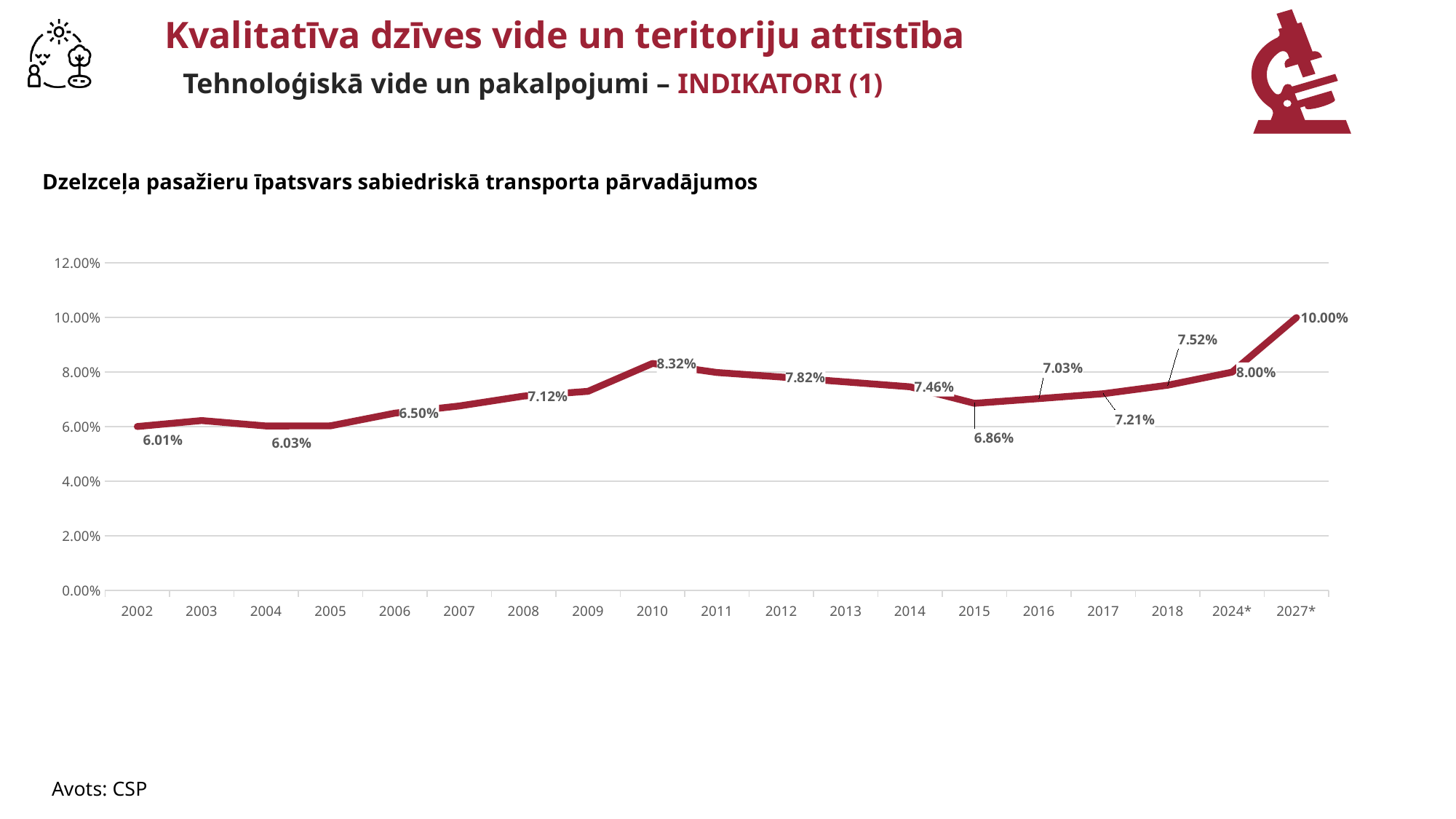
What kind of chart is shown on the slide? Line chart Which year has the highest value on the chart? 2027* What is the difference between the values for 2010 and 2015? 1.46% How many years are shown on the x axis? 19 What is the difference between the values for 2027* and 2024*? 2.00% Is the value for 2009 greater or less than 6.00%? greater Is the value for 2013 greater or less than 8.00%? less What is the value for 2024*? 8.00% Do the values rise or fall from 2015 to 2027*? Rise What is the value for 2010? 8.32% Which is larger, the value for 2010 or the value for 2012? 2010 What is the value for 2015? 6.86%